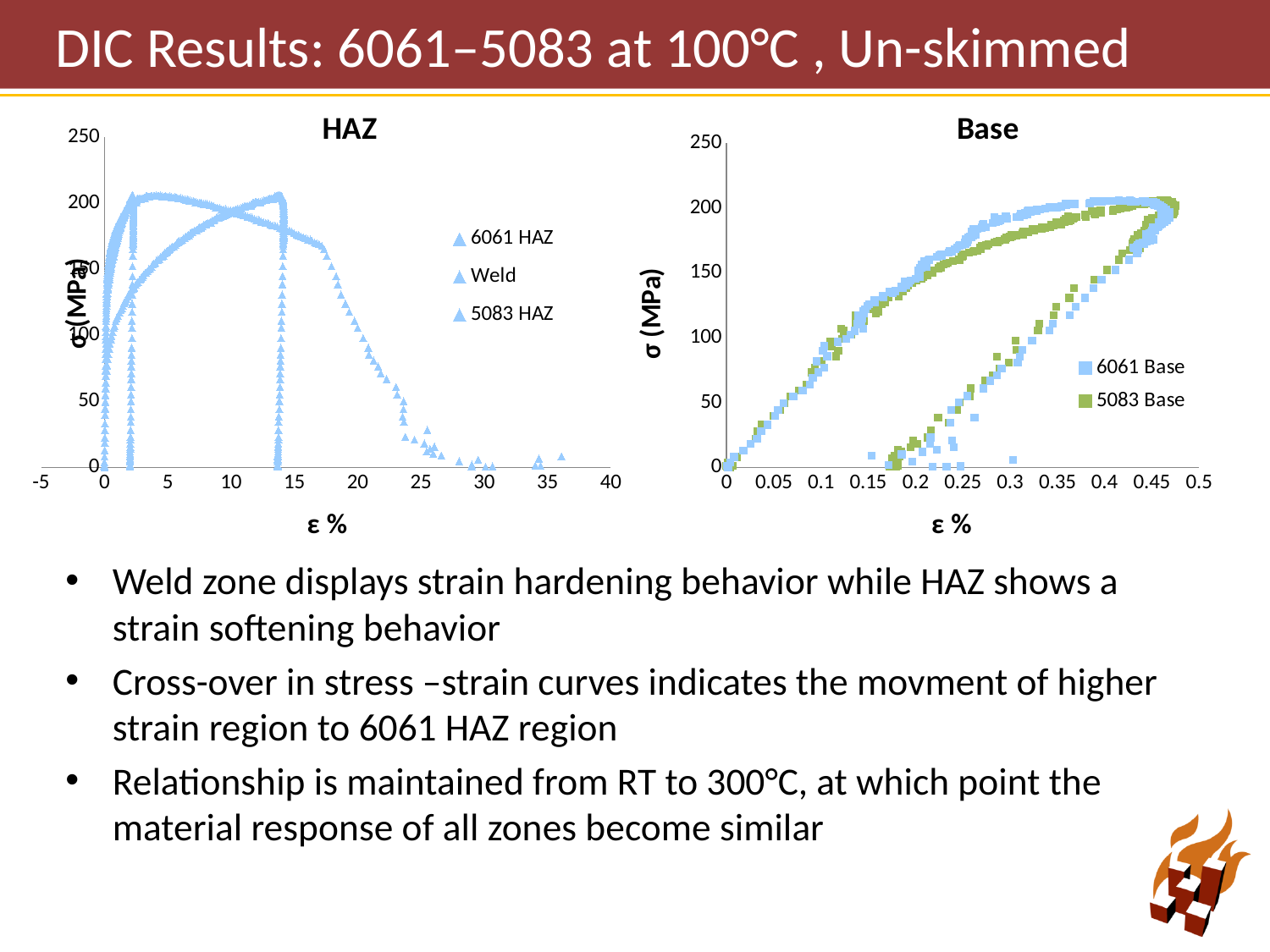
How many series does the legend of the Base chart list? 2 In the Base chart, is the largest strain value reached by the data points greater or less than 0.5? less In the HAZ chart, is the peak stress reached by the curves greater or less than 250 MPa? less What kind of chart is the HAZ chart on the left? scatter chart How many series does the legend of the HAZ chart list? 3 In the Base chart, what is the label of the y axis? σ (MPa) In the Base chart, is the largest strain value reached by the data points greater or less than 0.4? greater What kind of chart is the Base chart on the right? scatter chart In the HAZ chart, which series are listed in the legend? 6061 HAZ, Weld, 5083 HAZ